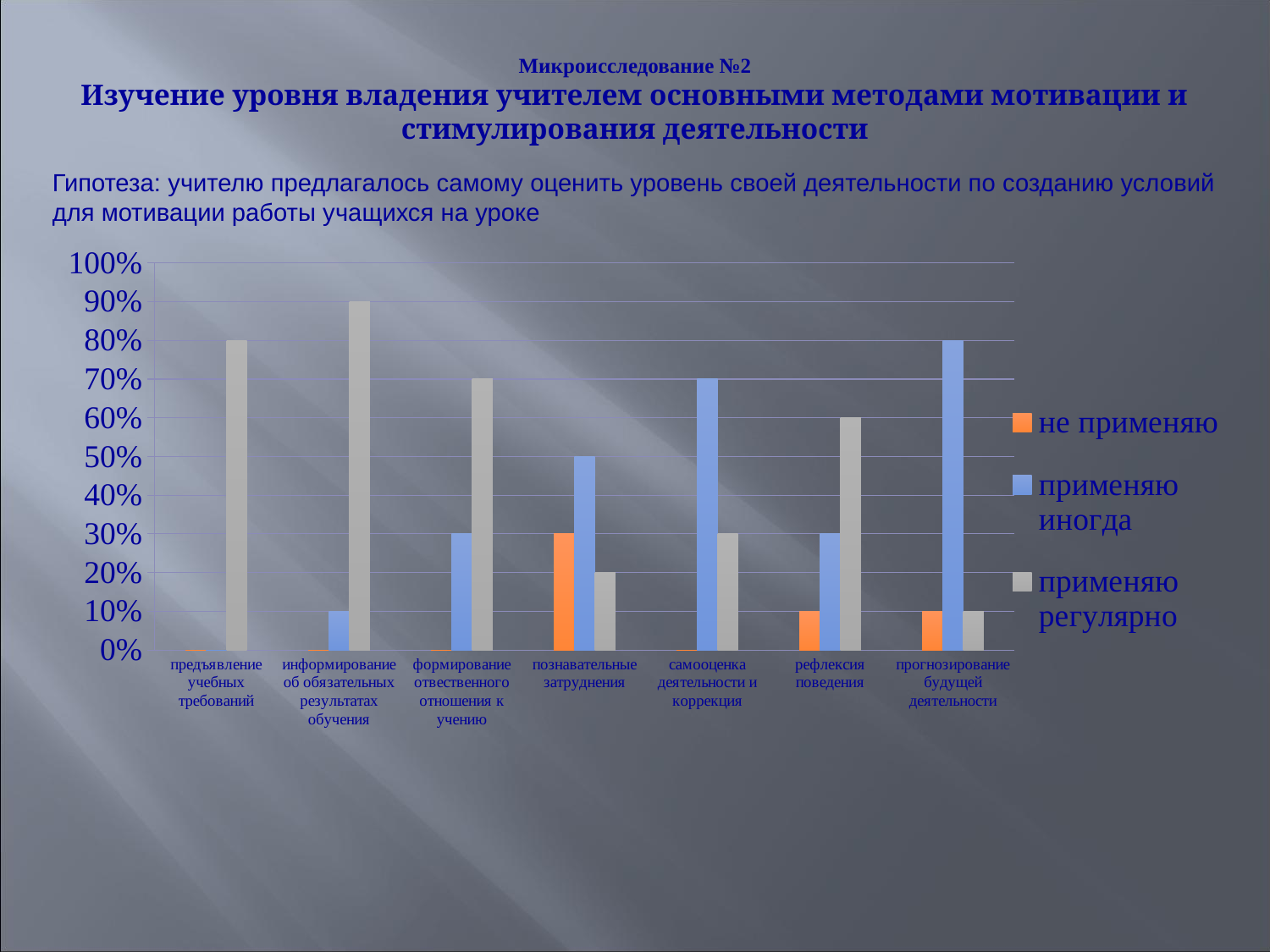
For "рефлексия поведения", which is larger: "применяю иногда" or "применяю регулярно"? применяю регулярно What is the difference between "применяю иногда" and "применяю регулярно" for "самооценка деятельности и коррекция"? 40% What type of chart is shown on the slide? bar chart Which category has the highest value for "применяю иногда"? прогнозирование будущей деятельности Which category has the highest value for "применяю регулярно"? информирование об обязательных результатах обучения How many categories are shown along the x axis of the chart? 7 Is the value of "применяю регулярно" for "предъявление учебных требований" greater or less than 50%? greater What is the value of "применяю регулярно" for "информирование об обязательных результатах обучения"? 90% What is the value of "применяю иногда" for "прогнозирование будущей деятельности"? 80% Which series in the legend is shown in orange? не применяю What is the value of "не применяю" for "познавательные затруднения"? 30% How many series does the chart's legend list? 3